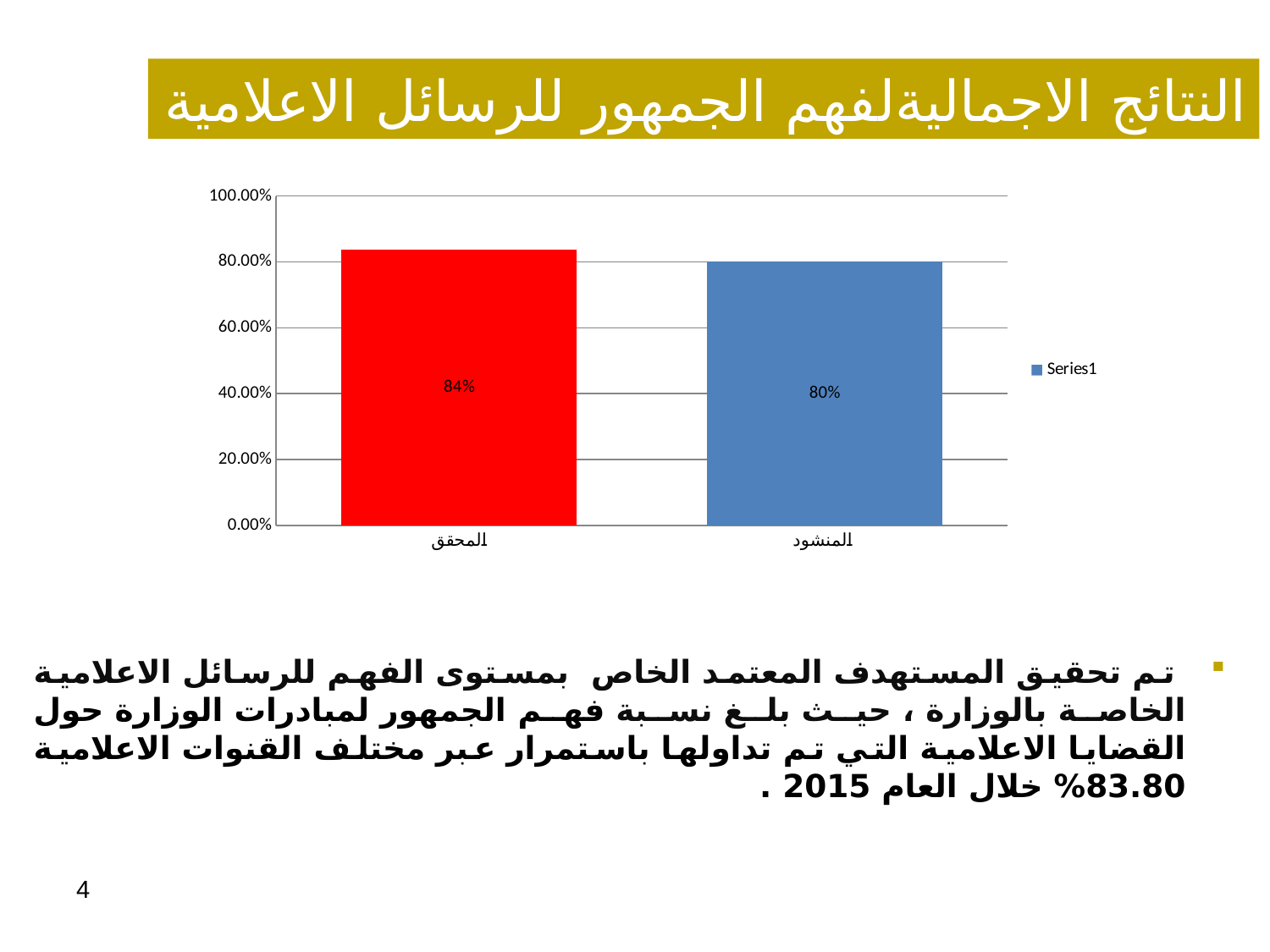
What is the value for المحقق? 84% How many series does the legend list? 1 What is the name of the series listed in the legend? Series1 What is the value for المنشود? 80% What is the difference between the values for المحقق and المنشود? 4% Which category has the lowest value? المنشود Is the value for المحقق greater or less than 100.00%? less Which category has the highest value? المحقق Which is larger, the value for المحقق or the value for المنشود? المحقق Is the value for المنشود greater or less than 60.00%? greater What kind of chart is shown on the slide? bar chart How many categories are shown on the x axis? 2